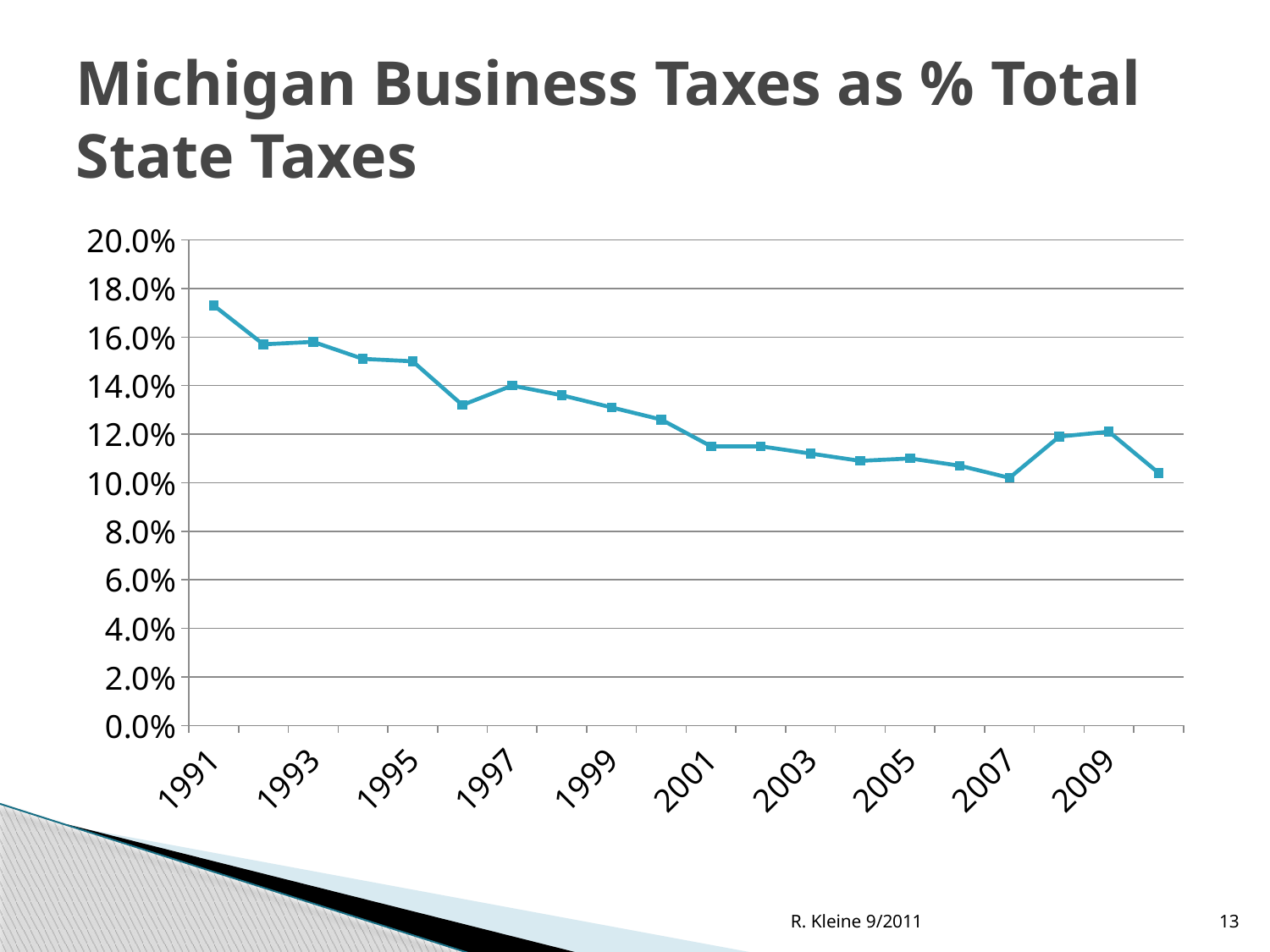
Is the value for 2001 greater or less than 12.0%? less Is the value for 1991 greater or less than 16.0%? greater Overall, do the values rise or fall from 1991 to the end of the series? fall Which is larger, the value for 2009 or the value for 2007? 2009 What is the title of the chart? Michigan Business Taxes as % Total State Taxes Is the value for 2007 greater or less than 12.0%? less Which year has the highest value on the chart? 1991 Which is larger, the value for 1991 or the value for 2007? 1991 What kind of chart is shown on the slide? line chart What is the highest value shown on the vertical axis? 20.0%